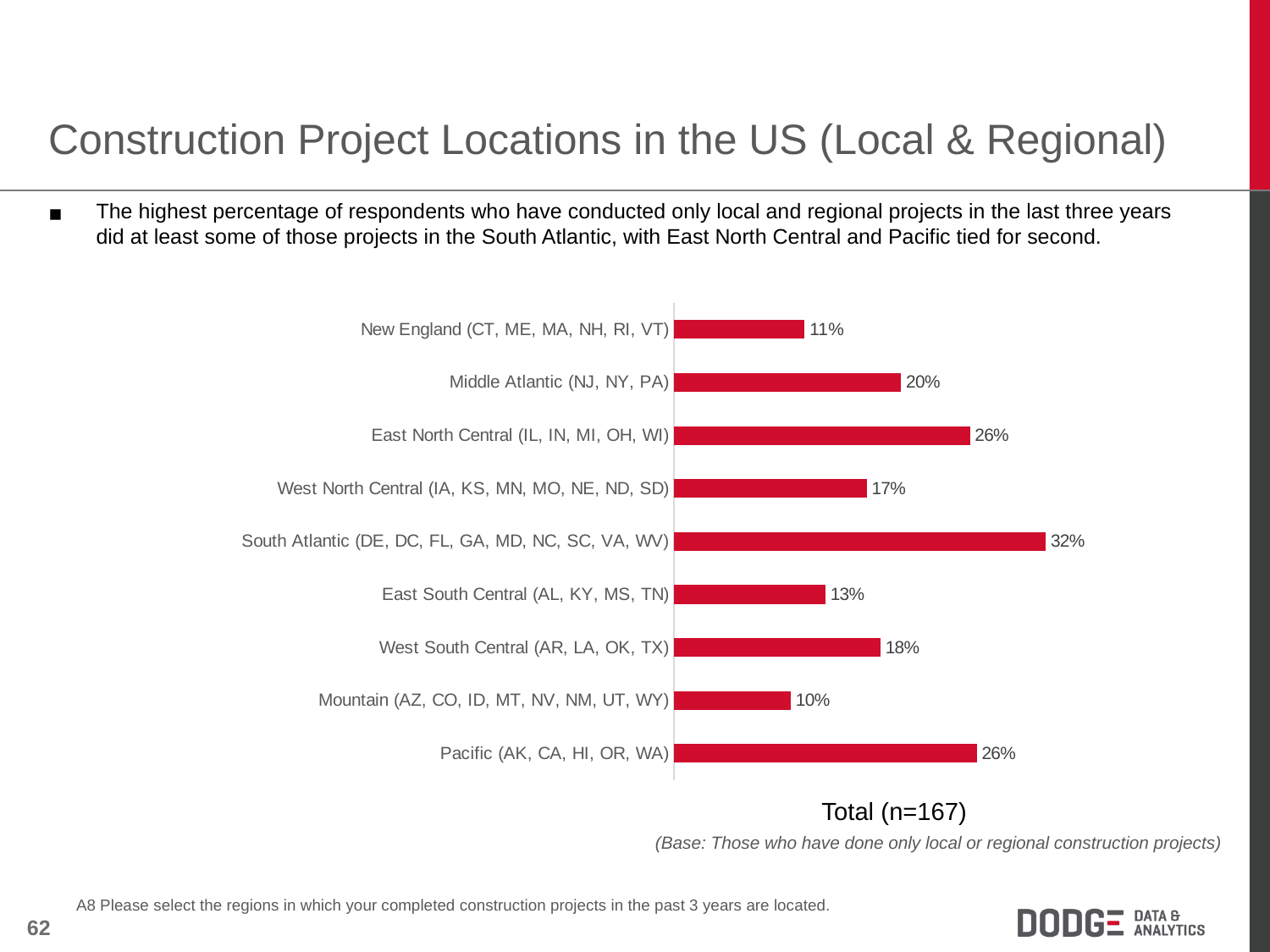
Which region has the lowest percentage? Mountain What is the sample size (n) shown below the chart? 167 Which region has the highest percentage? South Atlantic What percentage is shown for West North Central? 17% What is the value shown for the Mountain region? 10% How many regions are shown in the chart? 9 What type of chart is shown on the slide? Bar chart What is the difference between the South Atlantic and New England percentages? 21% What is the difference between the Middle Atlantic and East South Central values? 7% What percentage of respondents did projects in the South Atlantic region? 32% Which two regions are tied at 26%? East North Central and Pacific Which is larger, the value for West South Central or the value for West North Central? West South Central